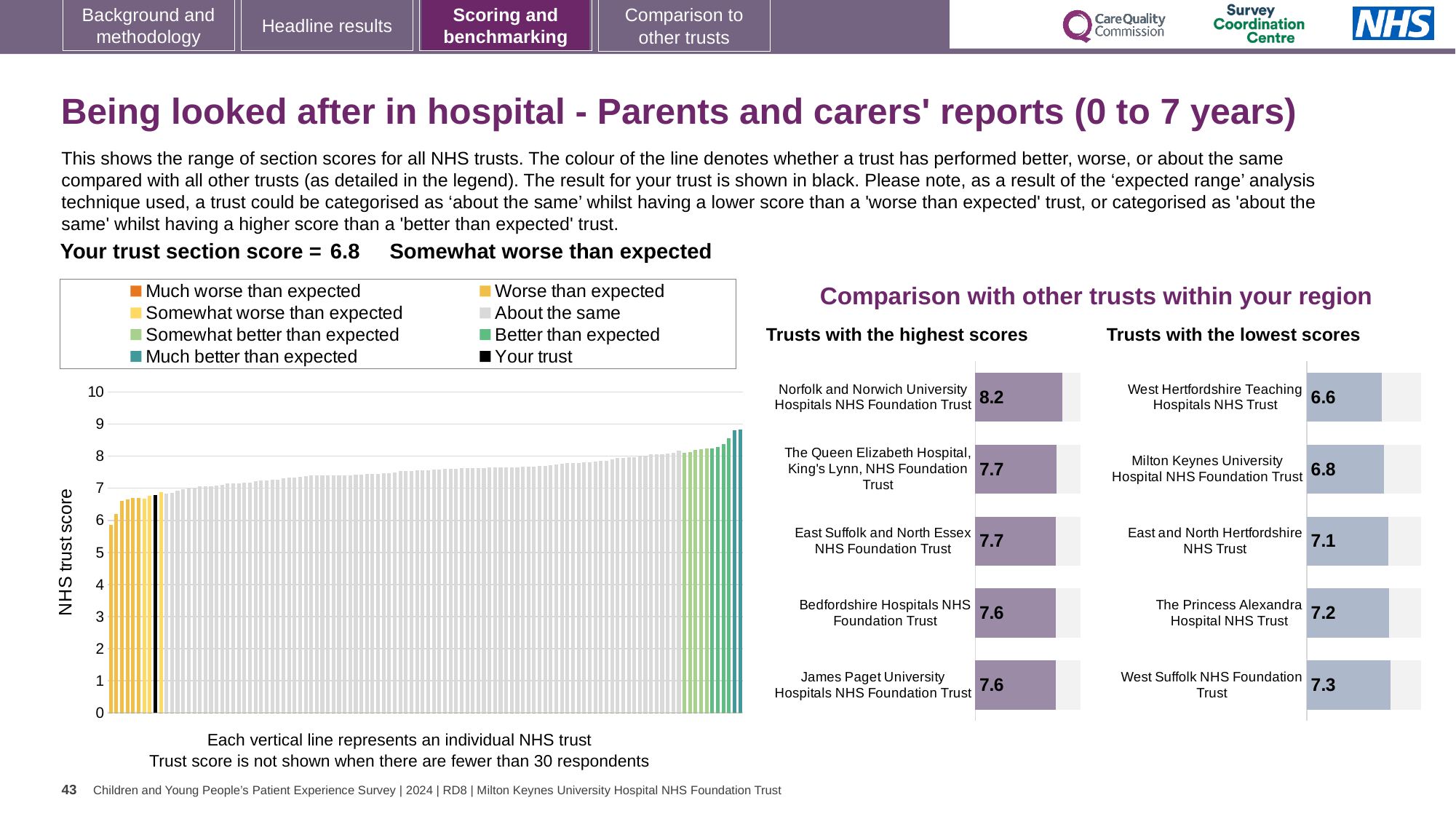
In the 'Trusts with the lowest scores' chart, what is the score for West Hertfordshire Teaching Hospitals NHS Trust? 6.6 In the 'Trusts with the lowest scores' chart, which has the larger score: Milton Keynes University Hospital NHS Foundation Trust or East and North Hertfordshire NHS Trust? East and North Hertfordshire NHS Trust In the 'Trusts with the lowest scores' chart, which trust has the lowest score? West Hertfordshire Teaching Hospitals NHS Trust In the main NHS trust score chart on the left, what colour is used for 'Your trust' according to the legend? Black How many entries does the legend of the main NHS trust score chart on the left list? 8 In the main NHS trust score chart on the left, do the bar values rise or fall from left to right? Rise In the 'Trusts with the highest scores' chart, what is the score for Norfolk and Norwich University Hospitals NHS Foundation Trust? 8.2 In the 'Trusts with the highest scores' chart, which trust has the highest score? Norfolk and Norwich University Hospitals NHS Foundation Trust What kind of chart is the main NHS trust score chart on the left of the slide? Bar chart How many trusts are listed in the 'Trusts with the highest scores' chart? 5 In the 'Trusts with the highest scores' chart, what is the difference between the scores of Norfolk and Norwich University Hospitals NHS Foundation Trust and James Paget University Hospitals NHS Foundation Trust? 0.6 In the 'Trusts with the lowest scores' chart, what is the difference between the scores of West Suffolk NHS Foundation Trust and West Hertfordshire Teaching Hospitals NHS Trust? 0.7